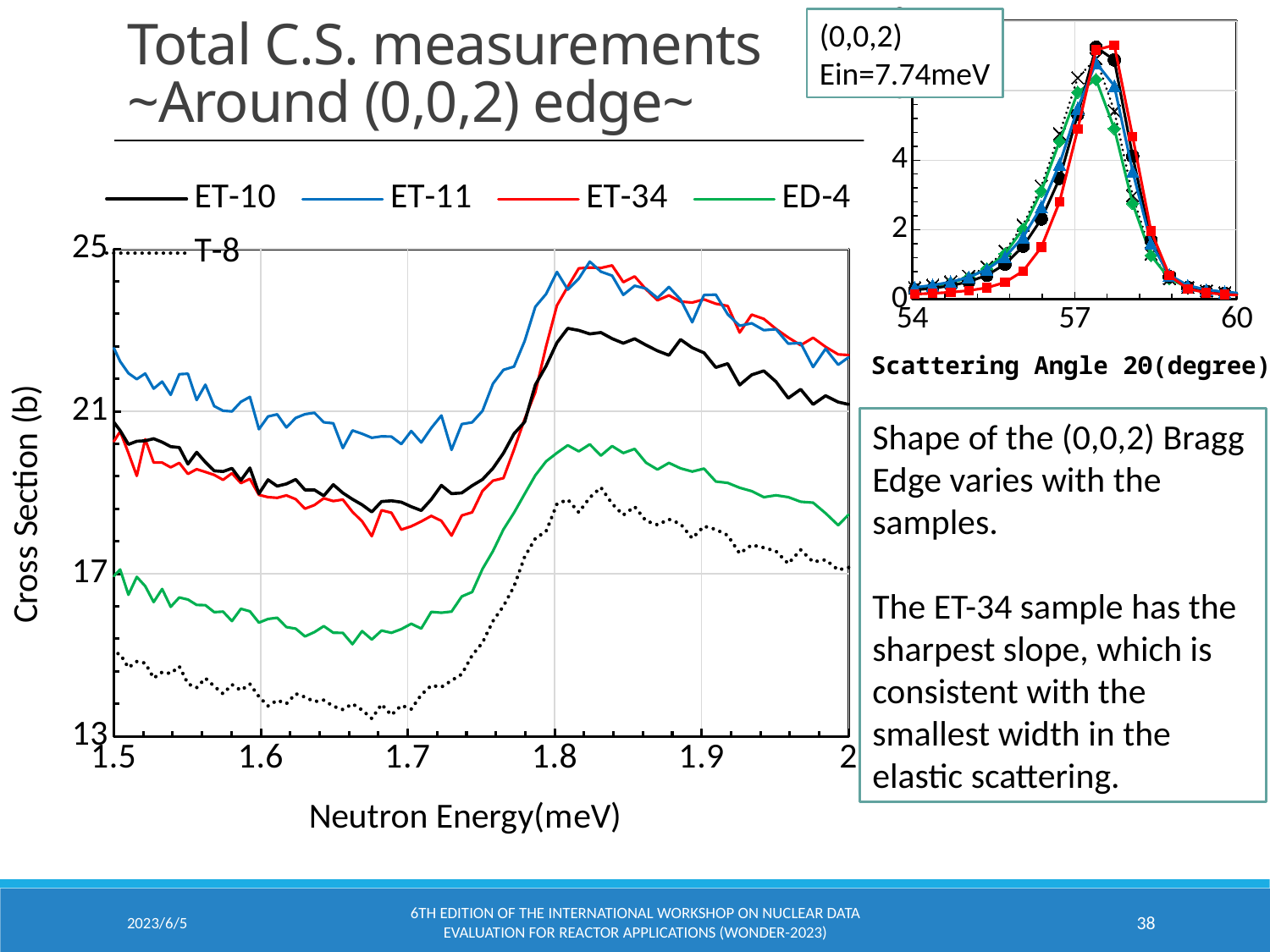
In the main chart, does the ET-10 cross section rise or fall between 1.7 meV and 1.8 meV? rise In the inset chart at the top right, is the peak located at a scattering angle greater or less than 57 degrees? greater In the main chart, is the value for ED-4 at 1.7 meV greater or less than 17? less What kind of chart is the main chart of Cross Section versus Neutron Energy? line chart In the main chart, at 1.9 meV, which is larger: ET-11 or ED-4? ET-11 In the main chart, is the value for ET-34 at 1.7 meV greater or less than 21? less What is the x-axis label of the main chart? Neutron Energy(meV) How many series does the legend of the main chart list? 5 In the main chart, which series has the lowest cross section across the whole energy range? T-8 In the main chart, which series is plotted with a dotted line? T-8